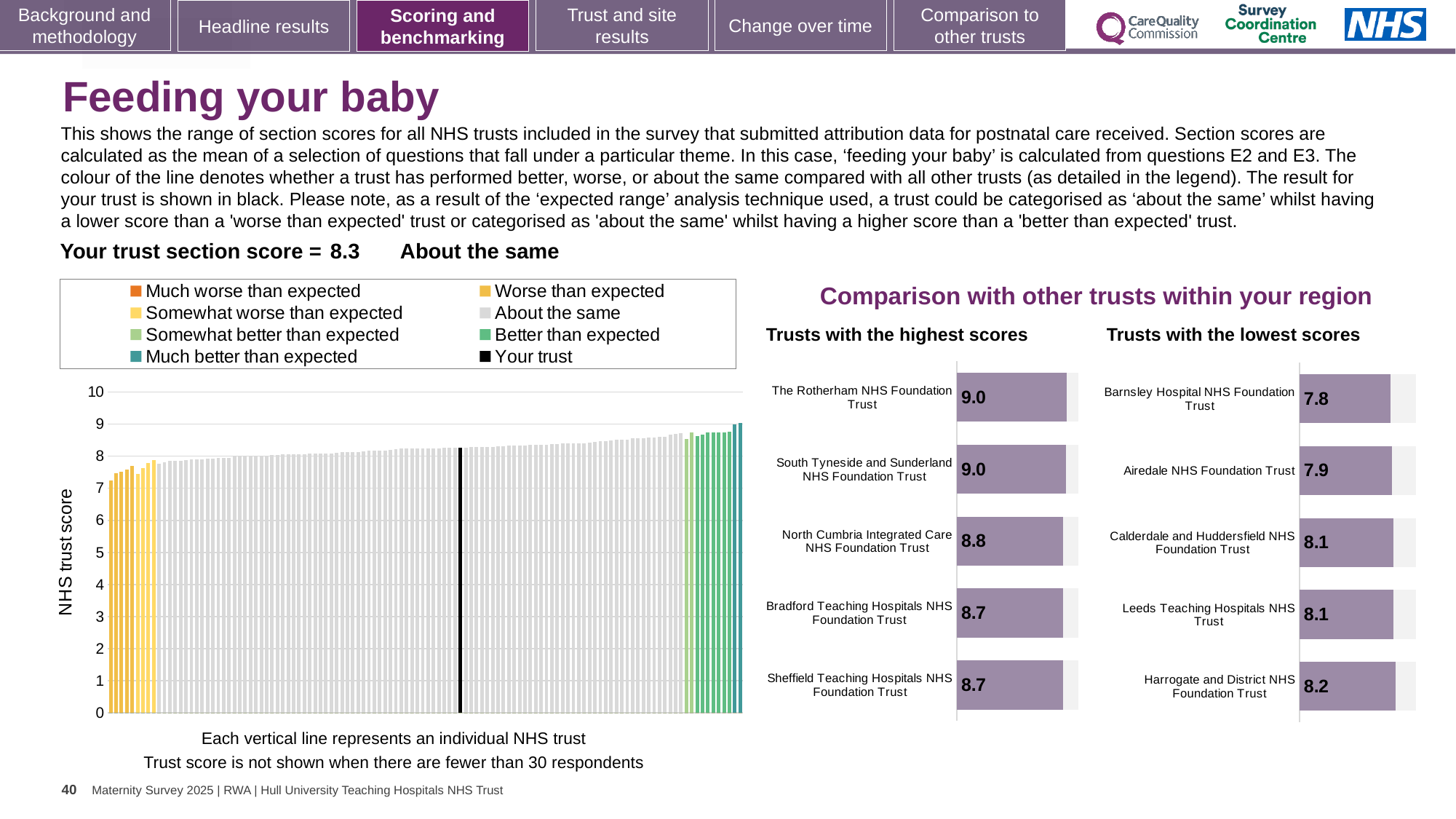
How many trusts are listed in the 'Trusts with the highest scores' chart? 5 In the 'Trusts with the highest scores' chart, what is the score for North Cumbria Integrated Care NHS Foundation Trust? 8.8 In the 'Trusts with the lowest scores' chart, which trust has the lowest score? Barnsley Hospital NHS Foundation Trust What is the section score for your trust shown on the slide? 8.3 In the 'Trusts with the lowest scores' chart, what is the score for Harrogate and District NHS Foundation Trust? 8.2 In the 'NHS trust score' chart, what colour is used for the bar representing your trust? Black In the 'Trusts with the lowest scores' chart, which trust has the highest score? Harrogate and District NHS Foundation Trust In the 'NHS trust score' chart, do the values rise or fall from left to right? Rise What kind of chart is the 'NHS trust score' chart on the left? Bar chart In the 'Trusts with the lowest scores' chart, what is the difference between the scores of Harrogate and District NHS Foundation Trust and Barnsley Hospital NHS Foundation Trust? 0.4 In the 'Trusts with the lowest scores' chart, which has the higher score: Airedale NHS Foundation Trust or Leeds Teaching Hospitals NHS Trust? Leeds Teaching Hospitals NHS Trust How many entries does the legend of the 'NHS trust score' chart list? 8